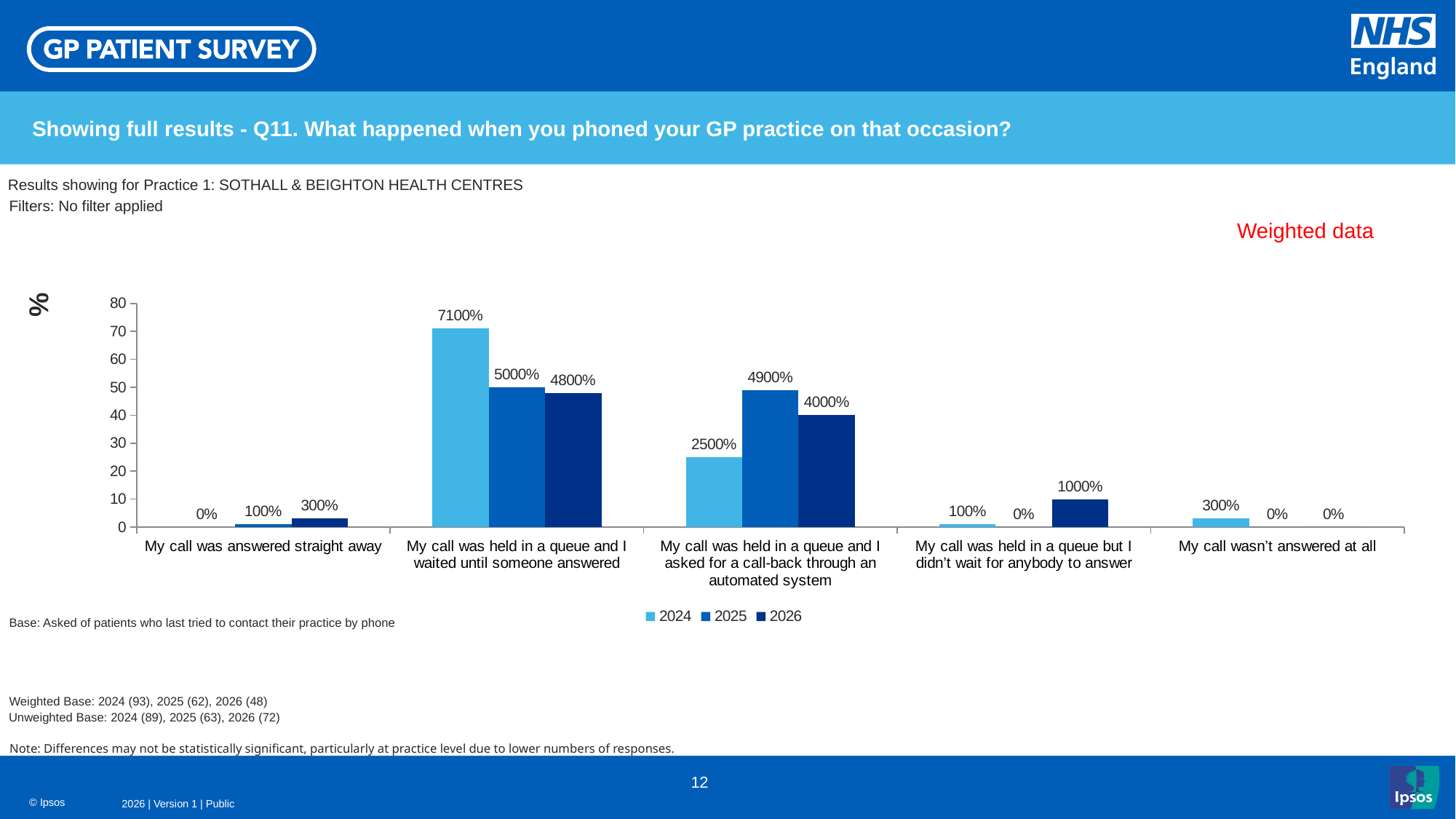
Is the 2024 bar for 'My call was held in a queue and I waited until someone answered' greater or less than 60 on the axis? greater What kind of chart is shown on the slide? Bar chart What is the data label for 2026 on 'My call was held in a queue and I asked for a call-back through an automated system'? 4000% Which category has the highest 2025 bar? My call was held in a queue and I waited until someone answered What is the data label for 2024 on 'My call was held in a queue and I waited until someone answered'? 7100% Which category has the highest 2024 bar? My call was held in a queue and I waited until someone answered What are the legend entries of the chart? 2024, 2025, 2026 How many series does the legend list? 3 How many categories are shown on the x axis? 5 What is the data label for 2025 on 'My call was answered straight away'? 100% For 'My call was held in a queue and I asked for a call-back through an automated system', which year has the larger bar, 2024 or 2025? 2025 What is the data label for 2026 on 'My call was held in a queue but I didn't wait for anybody to answer'? 1000%